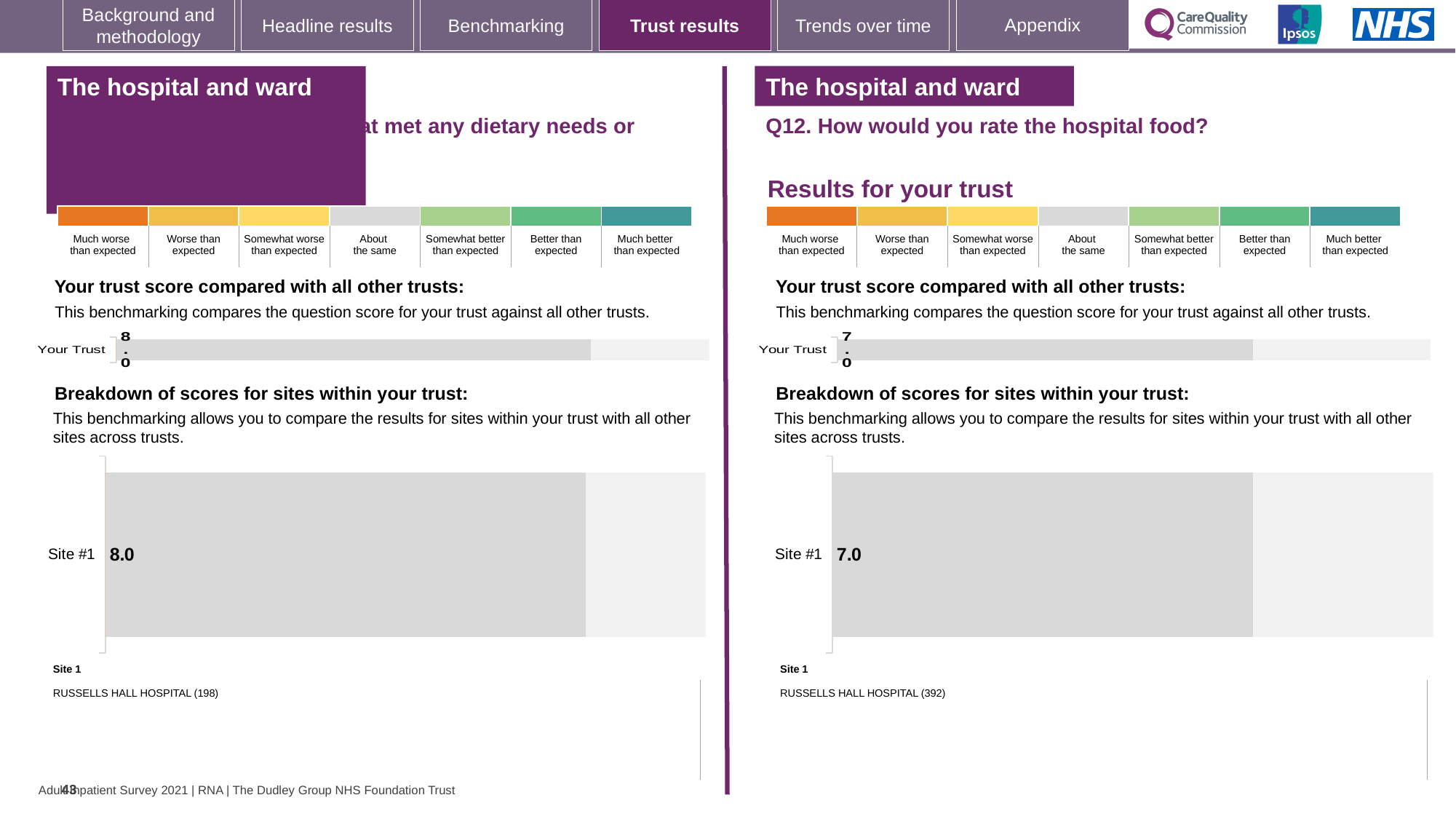
How many categories does the colour key above the right-hand chart (Q12) show, from 'Much worse than expected' to 'Much better than expected'? 7 Which is larger: the Your Trust score on the left-hand side of the slide or the Your Trust score on the right-hand side (Q12)? Left-hand side (8.0) On the left-hand side of the slide, what is the score shown for Your Trust? 8.0 In the right-hand 'Breakdown of scores for sites within your trust' chart (Q12), what is the score for Site #1? 7.0 How many sites are shown in the left-hand 'Breakdown of scores for sites within your trust' chart? 1 In the left-hand 'Breakdown of scores for sites within your trust' chart, what is the score for Site #1? 8.0 How many sites are shown in the right-hand 'Breakdown of scores for sites within your trust' chart (Q12)? 1 What type of chart is used to show the Site #1 score on the right-hand side of the slide (Q12)? Bar chart What is the difference between the Site #1 score on the left-hand side of the slide and the Site #1 score on the right-hand side (Q12)? 1.0 Which hospital is listed as Site 1 on the right-hand side of the slide (Q12)? RUSSELLS HALL HOSPITAL (392) On the right-hand side of the slide (Q12, hospital food), what is the score shown for Your Trust? 7.0